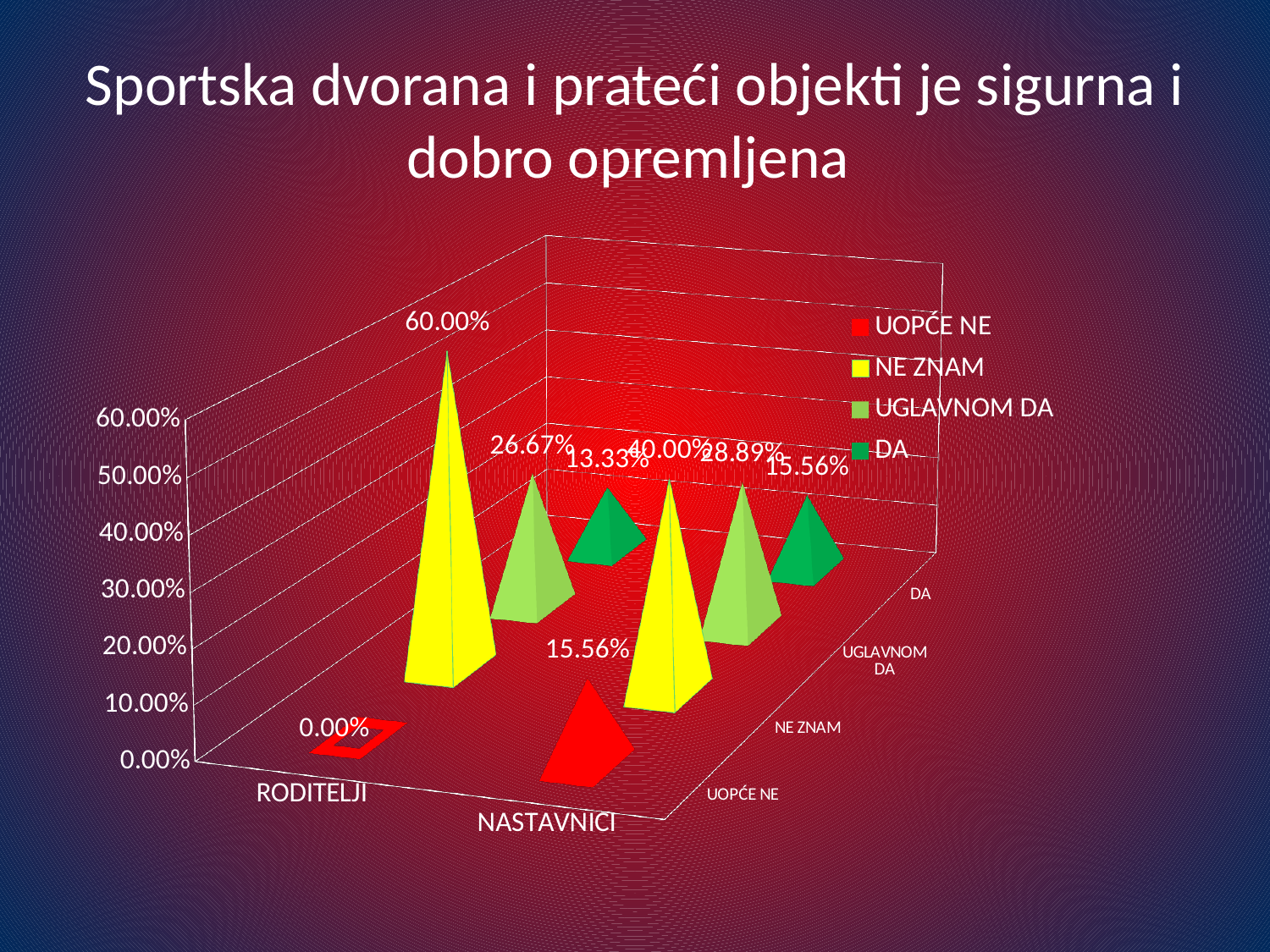
How many categories are shown on the x axis? 2 Which series has the lowest value in the RODITELJI category? UOPĆE NE What is the value for UOPĆE NE in the NASTAVNICI category? 15.56% What is the value for UOPĆE NE in the RODITELJI category? 0.00% Which is larger: the NE ZNAM value for RODITELJI or for NASTAVNICI? RODITELJI What is the difference between the NE ZNAM values for RODITELJI and NASTAVNICI? 20.00% What colour represents the NE ZNAM series in the legend? Yellow What kind of chart is shown on the slide? Bar chart How many series does the legend list? 4 What is the value for NE ZNAM in the RODITELJI category? 60.00% What is the value for NE ZNAM in the NASTAVNICI category? 40.00% Which series has the highest value in the RODITELJI category? NE ZNAM